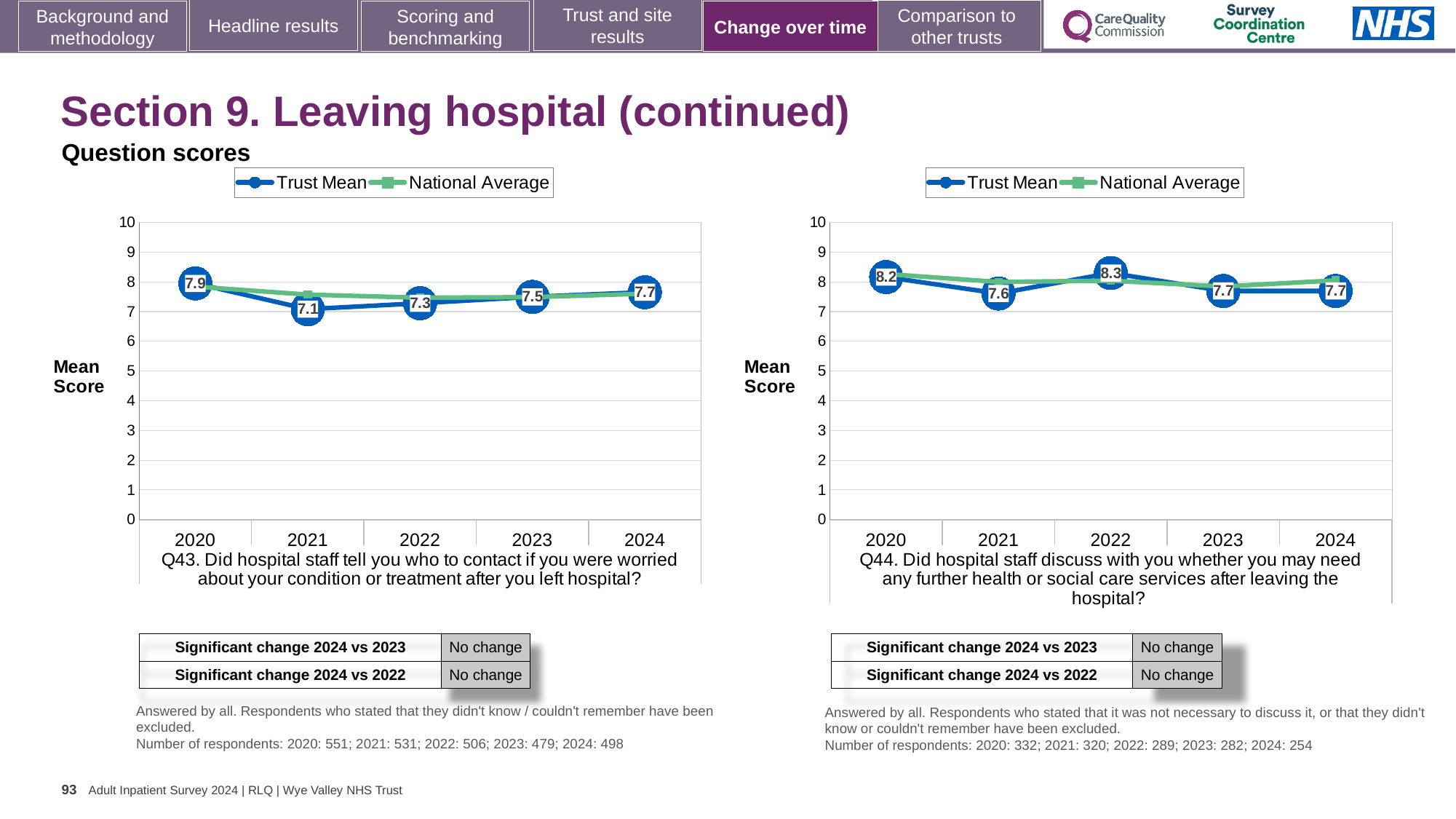
How many years are plotted on the x axis of the Q43 chart on the left? 5 In the Q44 chart on the right, which is larger, the Trust Mean score for 2020 or for 2023? 2020 In the Q43 chart on the left, which year has the highest Trust Mean score? 2020 In the Q43 chart on the left, does the Trust Mean rise or fall from 2021 to 2024? rise In the Q44 chart on the right, which year has the lowest Trust Mean score? 2021 In the Q44 chart on the right, what is the Trust Mean score for 2022? 8.3 How many series does the legend of the Q44 chart on the right list? 2 In the Q43 chart on the left, what is the Trust Mean score for 2024? 7.7 In the Q44 chart on the right, is the Trust Mean score for 2021 greater or less than 8? less In the Q43 chart on the left, what is the difference between the Trust Mean scores for 2020 and 2021? 0.8 In the Q43 chart on the left, what is the Trust Mean score for 2020? 7.9 In the Q43 chart on the left, which year has the lowest Trust Mean score? 2021